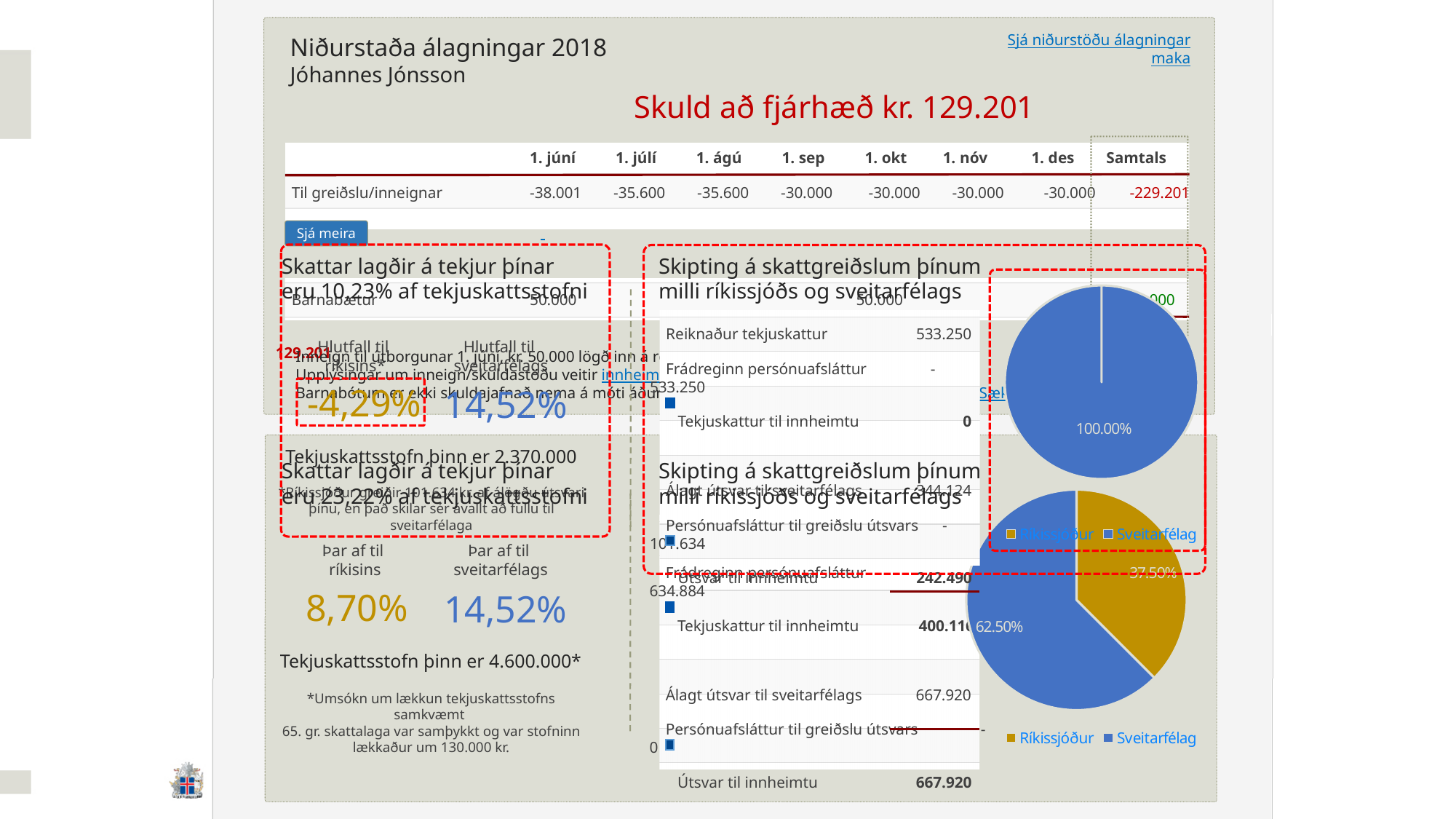
What kind of chart is the top chart on the right side of the slide? pie chart How many slices does the bottom pie chart have? 2 In the top pie chart, what share is shown for the Sveitarfélag slice? 100.00% How many entries does the legend of the top pie chart list? 2 In the bottom pie chart, what colour is the Ríkissjóður slice? gold In the bottom pie chart, what is the difference between the Sveitarfélag share and the Ríkissjóður share? 25.00% In the bottom pie chart, which slice is larger, Ríkissjóður or Sveitarfélag? Sveitarfélag What are the two legend entries of the bottom pie chart? Ríkissjóður and Sveitarfélag In the bottom pie chart, what share is shown for Sveitarfélag? 62.50% In the bottom pie chart, which category has the largest slice? Sveitarfélag In the bottom pie chart, which category has the smallest slice? Ríkissjóður In the bottom pie chart, what share is shown for Ríkissjóður? 37.50%